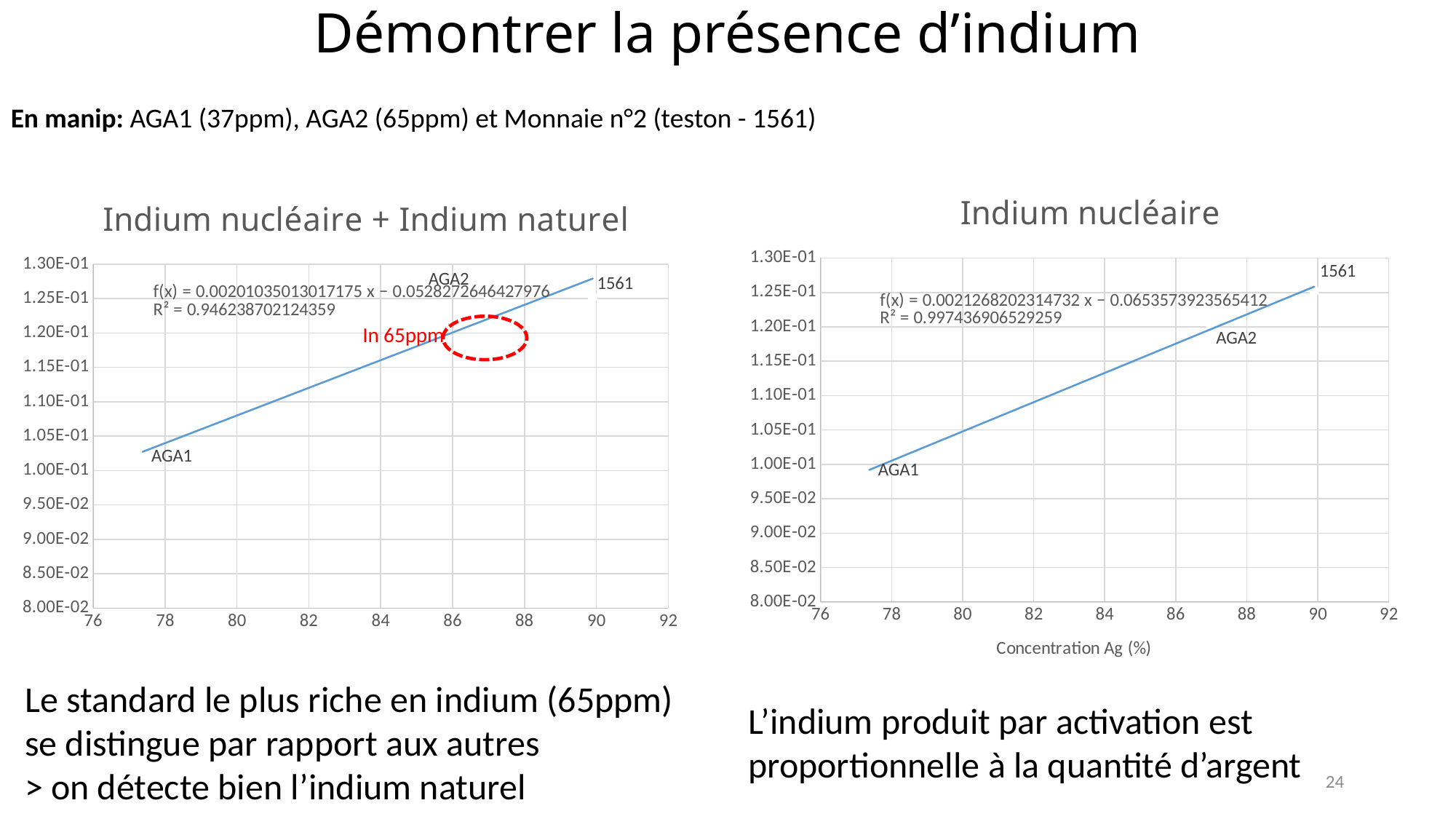
On the left chart "Indium nucléaire + Indium naturel", what is the R² value shown for the trendline? 0.946238702124359 How many data points are labelled on the right chart titled "Indium nucléaire"? 3 Which chart has the higher R² value, the left chart or the right chart? The right chart (Indium nucléaire) What is the x-axis title of the right chart "Indium nucléaire"? Concentration Ag (%) On the right chart "Indium nucléaire", what is the R² value shown for the trendline? 0.997436906529259 On the right chart "Indium nucléaire", which is larger, the value for AGA1 or the value for 1561? 1561 On the left chart "Indium nucléaire + Indium naturel", is the value for AGA1 greater or less than 1.00E-01? greater On the right chart "Indium nucléaire", do the values rise or fall as the concentration of Ag increases? Rise On the right chart "Indium nucléaire", which labelled point has the highest value? 1561 On the left chart "Indium nucléaire + Indium naturel", which labelled point has the lowest value? AGA1 What kind of chart is the left chart titled "Indium nucléaire + Indium naturel"? Scatter chart with a trendline On the right chart "Indium nucléaire", is the value for AGA2 greater or less than 1.15E-01? greater